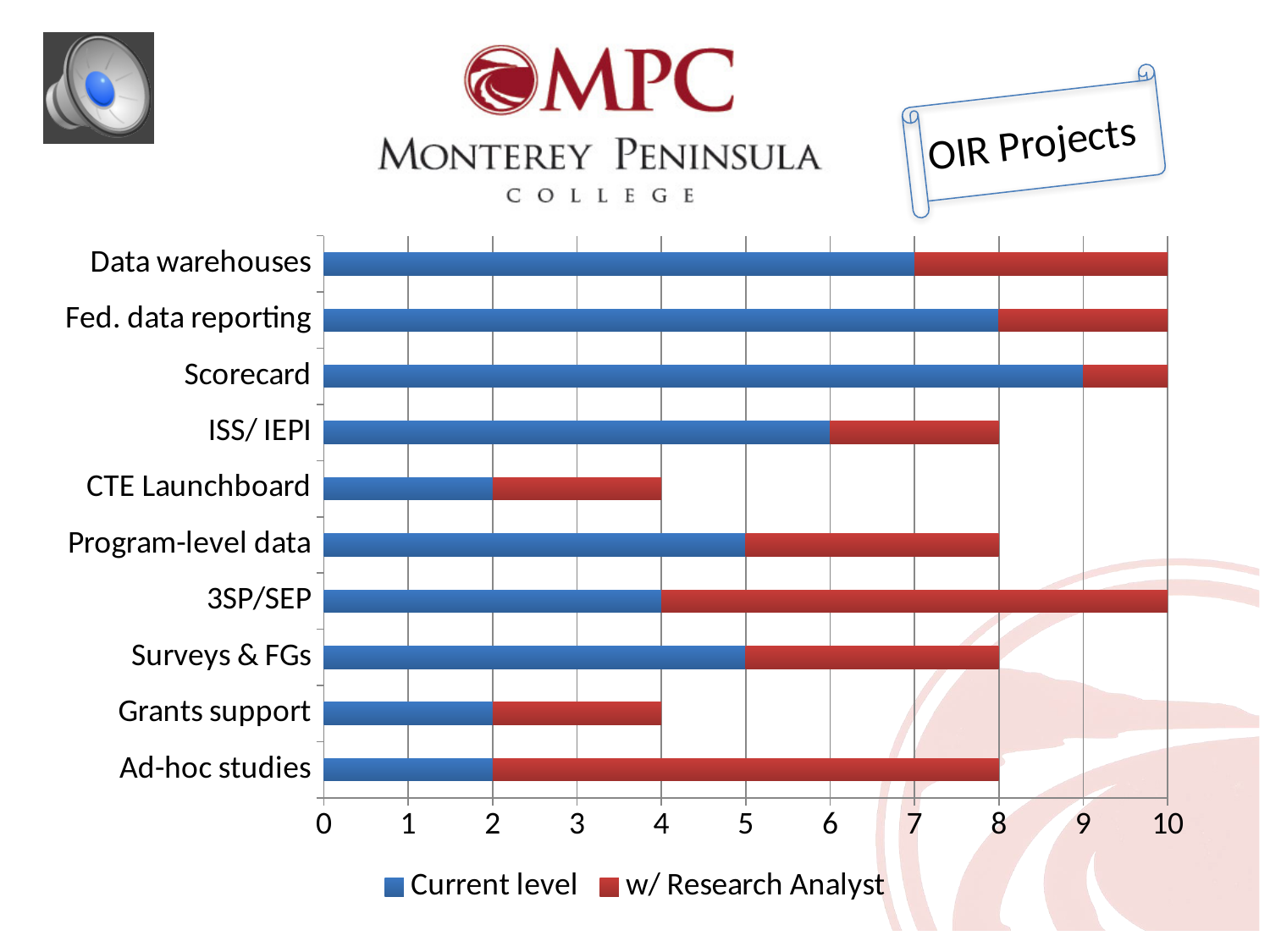
What is the Current level value for ISS/ IEPI? 6 What is the total of the stacked bar for Data warehouses? 10 How many series does the legend list? 2 What type of chart is shown on the slide? Stacked bar chart What is the Current level value for Scorecard? 9 How many categories are plotted on the chart? 10 Which category has the highest Current level value? Scorecard What is the total of the stacked bar for CTE Launchboard? 4 Which series is shown in red in the legend? w/ Research Analyst What is the difference between the Current level values for Fed. data reporting and 3SP/SEP? 4 Which has a larger Current level value, Program-level data or Data warehouses? Data warehouses What is the Current level value for Ad-hoc studies? 2